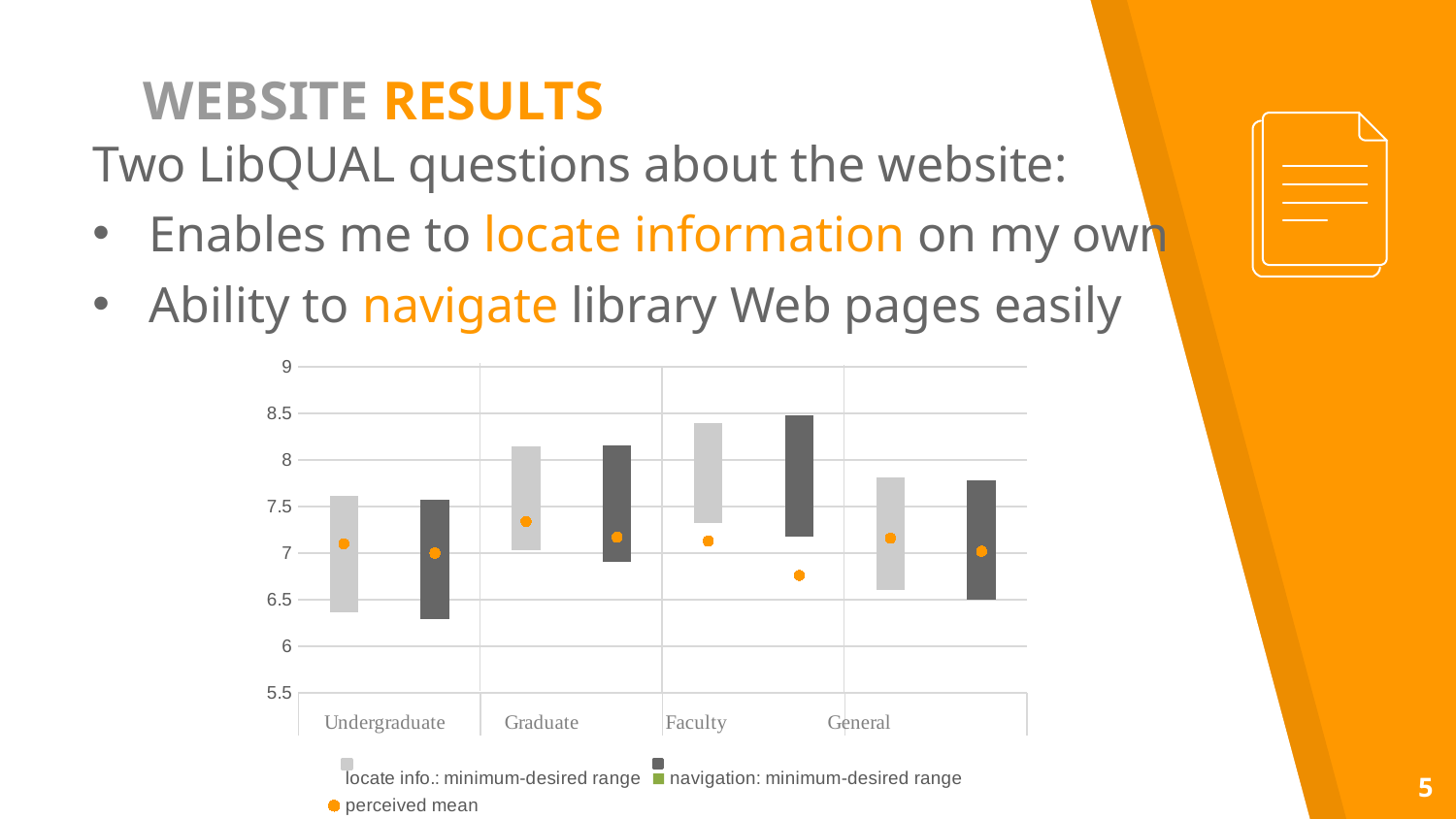
Is the bottom of the locate info. minimum-desired range for General greater or less than 7? less Is the top of the locate info. minimum-desired range for Undergraduate greater or less than 8? less Which category has the highest top of the navigation minimum-desired range? Faculty What colour are the perceived mean markers in the chart? orange Is the perceived mean for navigation in the Graduate category greater or less than 7? greater What kind of chart is shown on the slide? bar chart How many categories are shown on the x axis of the chart? 4 Which is larger: the perceived mean for navigation for Undergraduate or for Faculty? Undergraduate How many series does the chart legend list? 3 Which category has the lowest perceived mean for navigation? Faculty